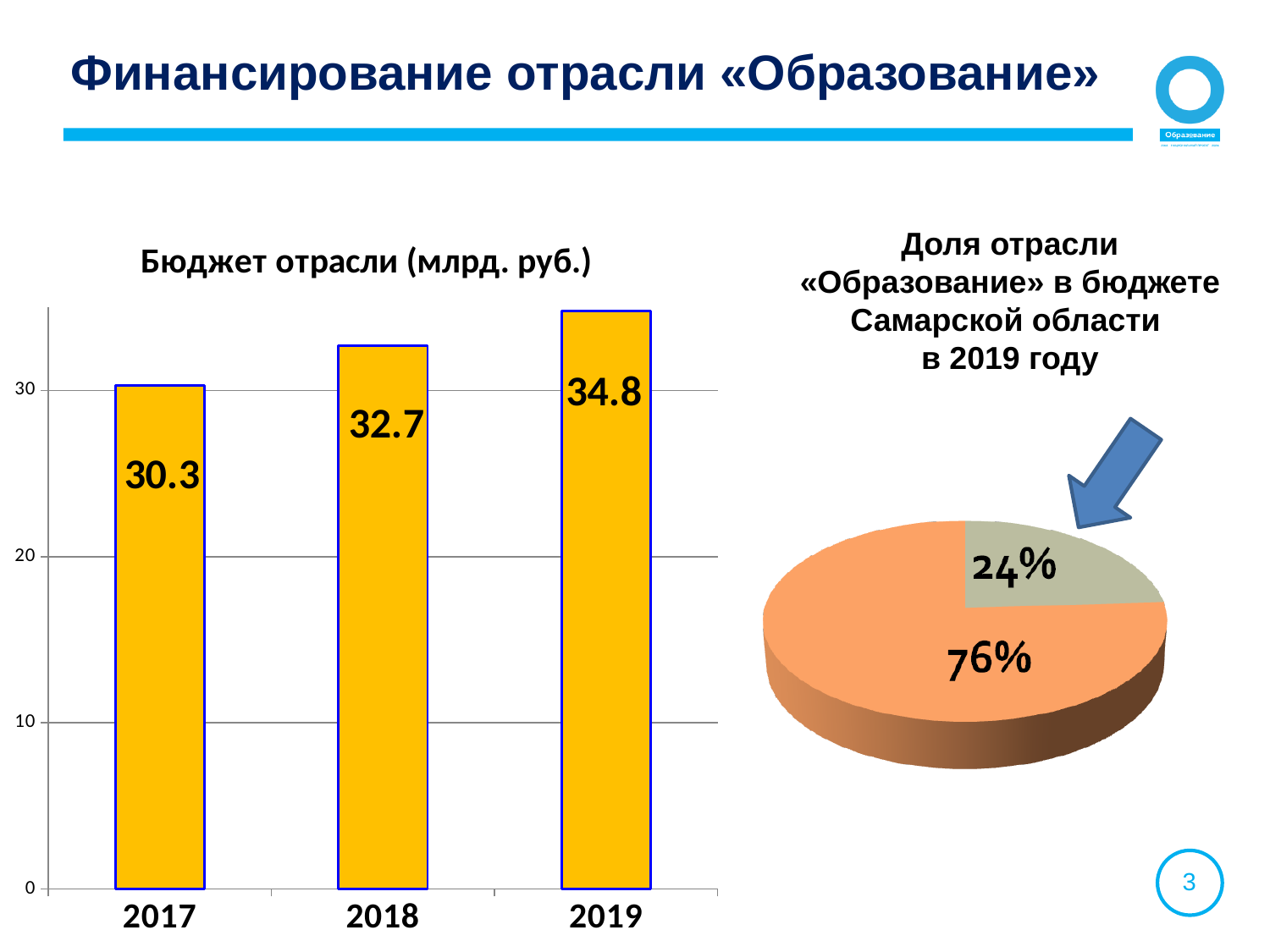
In the pie chart on the right, what is the share of the larger slice? 76% What kind of chart is the chart on the left of the slide? bar chart In the bar chart 'Бюджет отрасли (млрд. руб.)', do the values rise or fall from 2017 to 2019? rise In the bar chart 'Бюджет отрасли (млрд. руб.)', what is the value for 2017? 30.3 In the bar chart 'Бюджет отрасли (млрд. руб.)', what is the value for 2018? 32.7 In the pie chart on the right, what share does the slice indicated by the arrow represent? 24% In the bar chart 'Бюджет отрасли (млрд. руб.)', which is larger, the value for 2018 or the value for 2017? 2018 In the bar chart 'Бюджет отрасли (млрд. руб.)', how many years are shown? 3 In the bar chart 'Бюджет отрасли (млрд. руб.)', which year has the highest value? 2019 In the bar chart 'Бюджет отрасли (млрд. руб.)', what is the value for 2019? 34.8 In the bar chart 'Бюджет отрасли (млрд. руб.)', which year has the lowest value? 2017 In the bar chart 'Бюджет отрасли (млрд. руб.)', what is the difference between the 2019 and 2017 values? 4.5